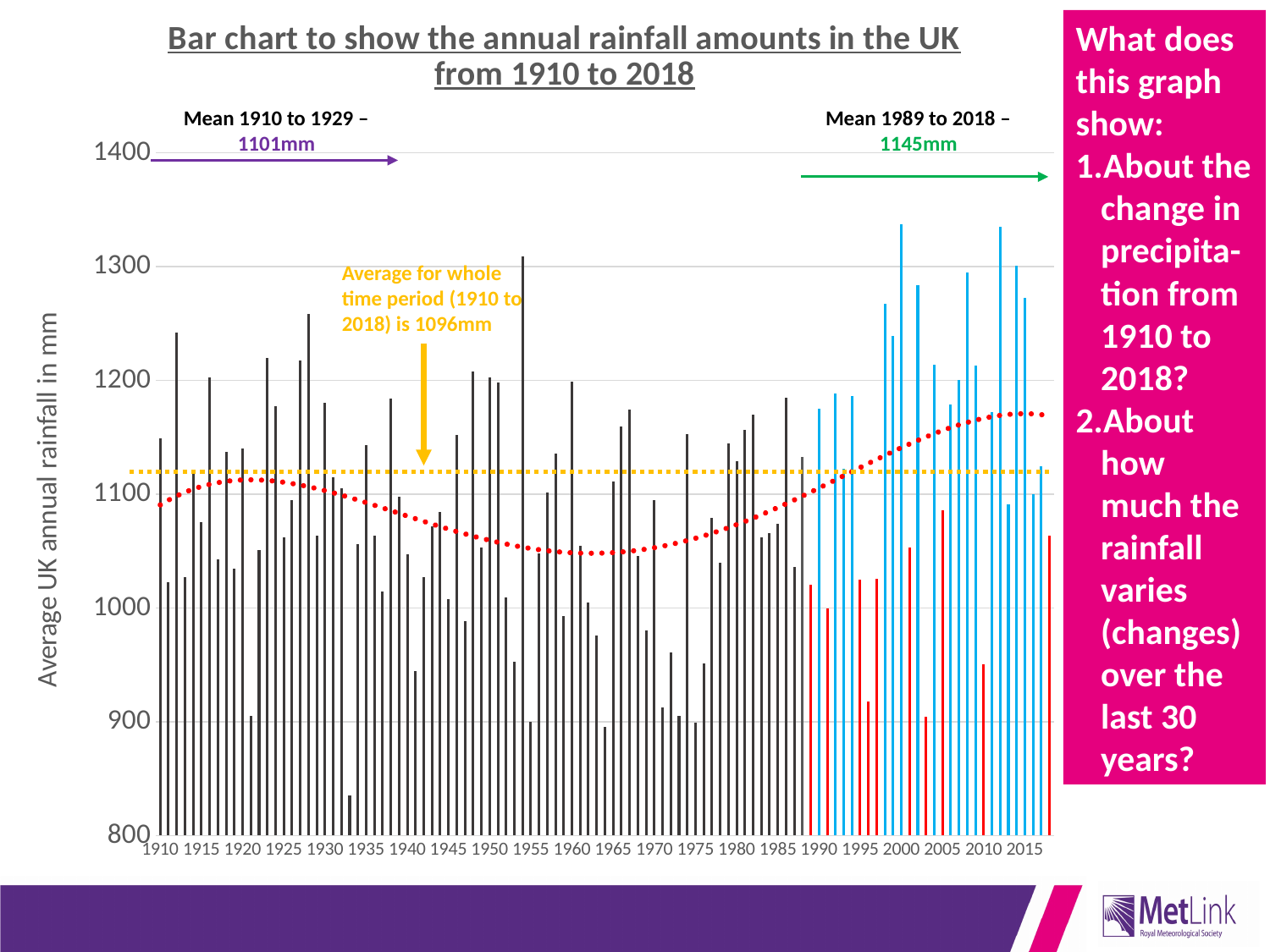
What is the average rainfall for the whole time period (1910 to 2018) shown on the chart? 1096mm What kind of chart is shown on the slide? Bar chart Does the red dotted trend line end higher or lower in 2018 than it starts in 1910? higher What is the mean annual rainfall for 1910 to 1929 shown on the chart? 1101mm What is the label on the vertical axis of the chart? Average UK annual rainfall in mm Which is larger: the mean for 1910 to 1929 or the mean for 1989 to 2018? Mean 1989 to 2018 Is the value for 2000 greater or less than 1300? greater Is the value for 1910 greater or less than 1100? greater Is the value for 1933 greater or less than 900? less How much higher is the mean for 1989 to 2018 than the mean for 1910 to 1929? 44mm What is the mean annual rainfall for 1989 to 2018 shown on the chart? 1145mm What is the title of the chart? Bar chart to show the annual rainfall amounts in the UK from 1910 to 2018